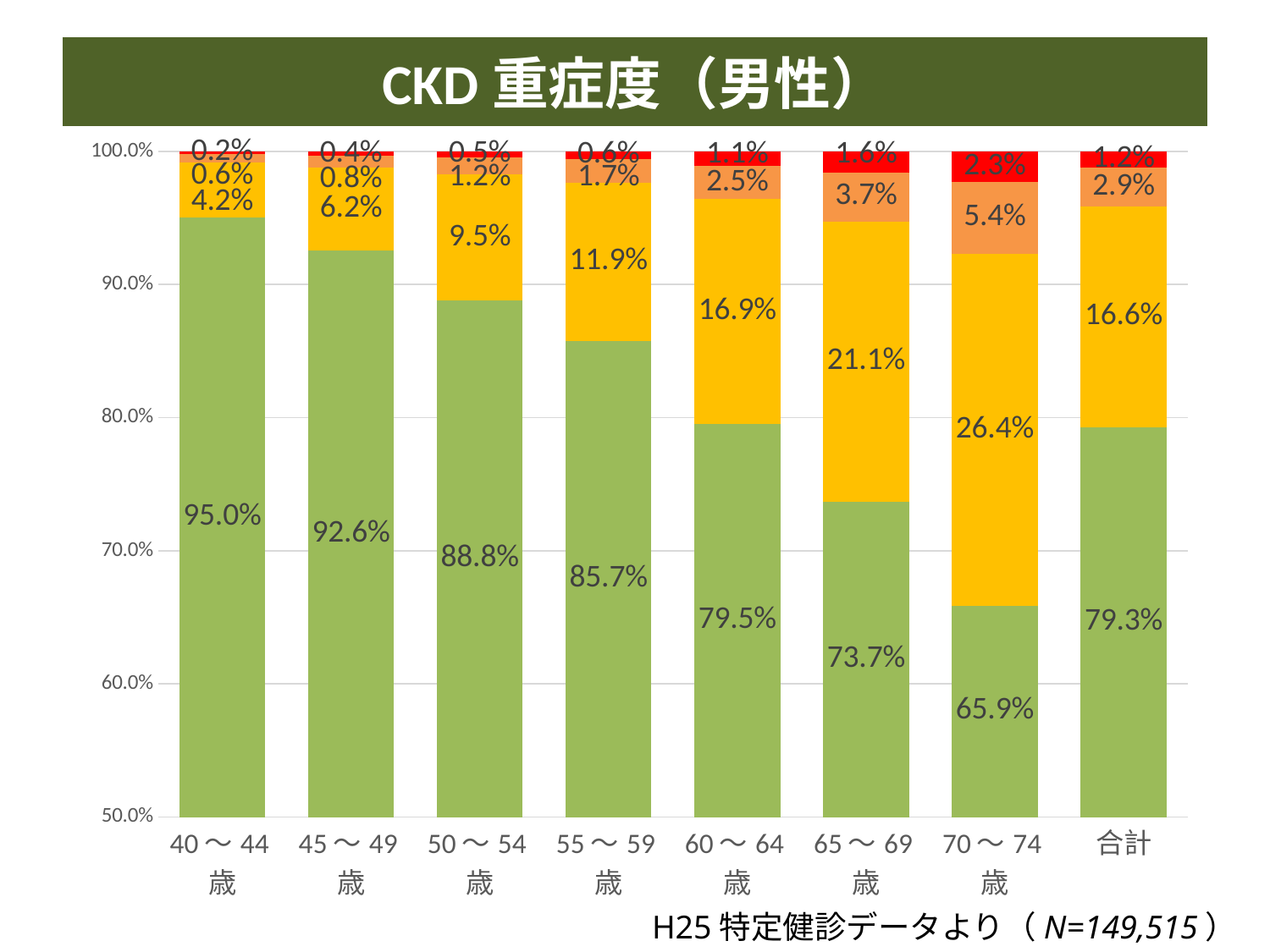
Which category has the highest value for the yellow segment? 70〜74歳 What is the value of the yellow segment for the 70〜74歳 category? 26.4% Which category has the lowest value for the green (bottom) segment? 70〜74歳 What kind of chart is shown on the slide? Stacked bar chart What is the value of the green (bottom) segment for the 合計 category? 79.3% How many categories are shown on the x axis? 8 What is the value of the green (bottom) segment for the 40〜44歳 category? 95.0% What is the difference between the green segment values for 40〜44歳 and 70〜74歳? 29.1% What is the title of the chart? CKD 重症度（男性） Which is larger: the yellow segment for 60〜64歳 or the yellow segment for 合計? 60〜64歳 Do the green (bottom) segment values rise or fall from 40〜44歳 to 70〜74歳? Fall What is the value of the orange segment for the 65〜69歳 category? 3.7%